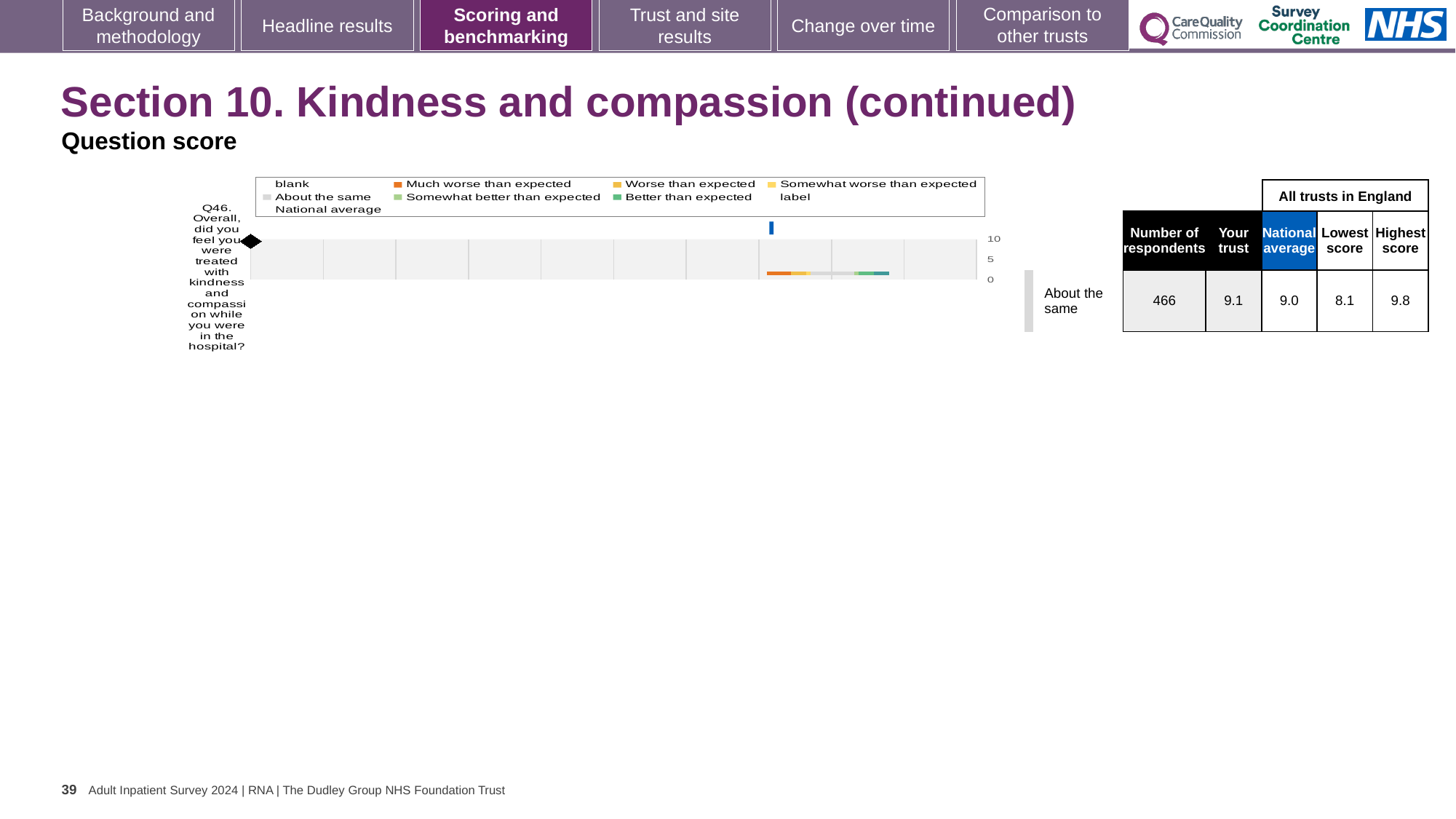
In the table beside the chart, what is the difference between the highest score and the lowest score for Q46? 1.7 Which question number is plotted on the chart? Q46 What kind of chart is shown on the slide for Q46? bar chart In the table beside the chart, what is the highest score among all trusts in England for Q46? 9.8 In the table beside the chart, what is the national average score for Q46? 9.0 How many questions (categories) are plotted on the chart? 1 Which benchmark category is shown for the trust's result on Q46? About the same In the table beside the chart, what is the 'Your trust' score for Q46? 9.1 How many entries does the chart's legend list? 9 In the table beside the chart, what is the lowest score among all trusts in England for Q46? 8.1 In the table beside the chart, what is the number of respondents for Q46? 466 What is the highest tick value shown on the chart's axis? 10